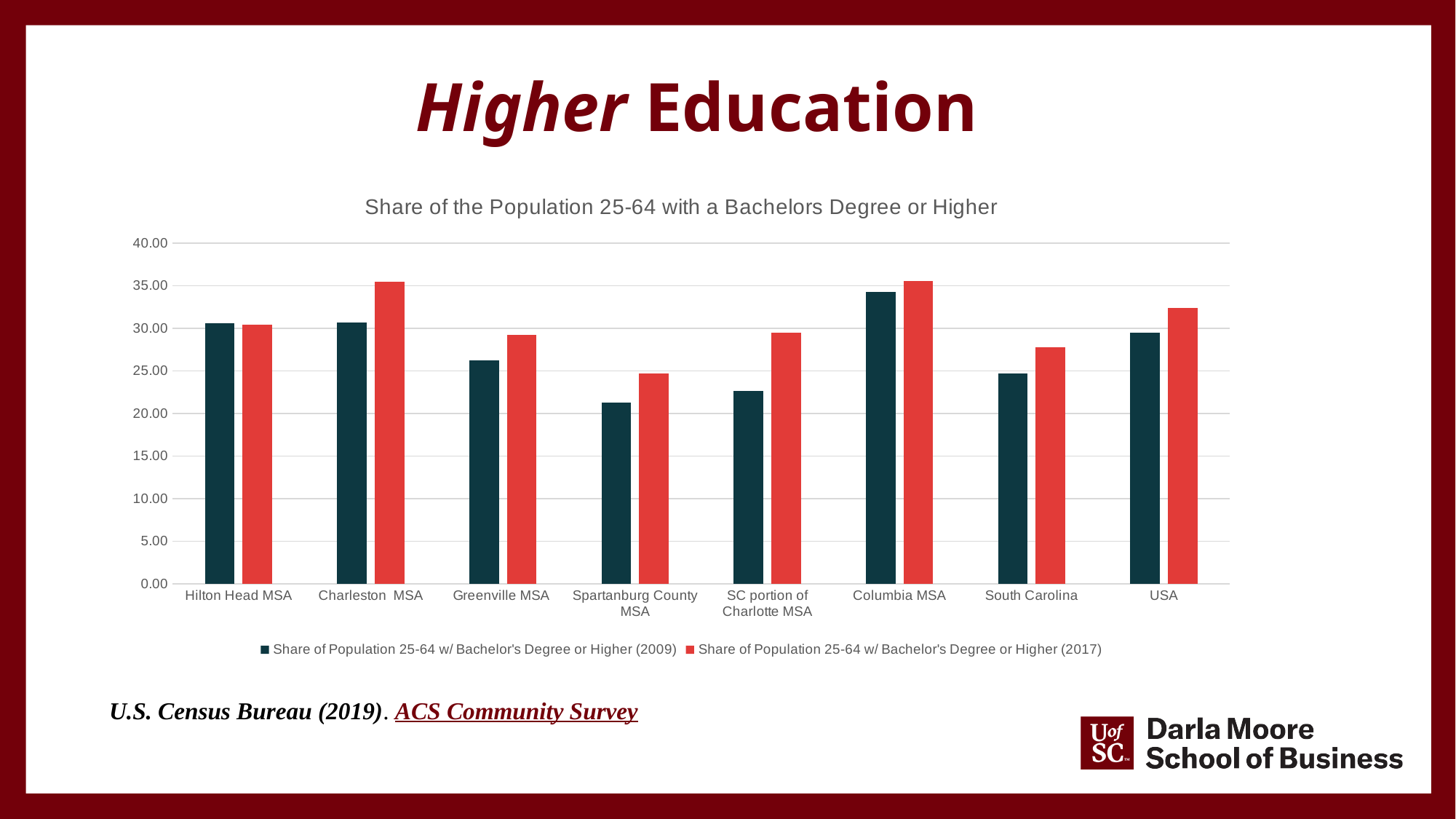
Which category has the highest value for the 2009 series? Columbia MSA Is the 2017 value for USA greater or less than 30.00? greater Which category has the lowest value for the 2009 series? Spartanburg County MSA Which category has the lowest value for the 2017 series? Spartanburg County MSA Is the 2009 value for SC portion of Charlotte MSA greater or less than 25.00? less What kind of chart is shown on the slide? bar chart What is the title of the chart? Share of the Population 25-64 with a Bachelors Degree or Higher Is the 2009 value for Spartanburg County MSA greater or less than 25.00? less For the 2009 series, which is larger: South Carolina or USA? USA How many categories are shown along the x axis of the chart? 8 For the 2017 series, which is larger: Charleston MSA or Hilton Head MSA? Charleston MSA How many series does the chart's legend list? 2